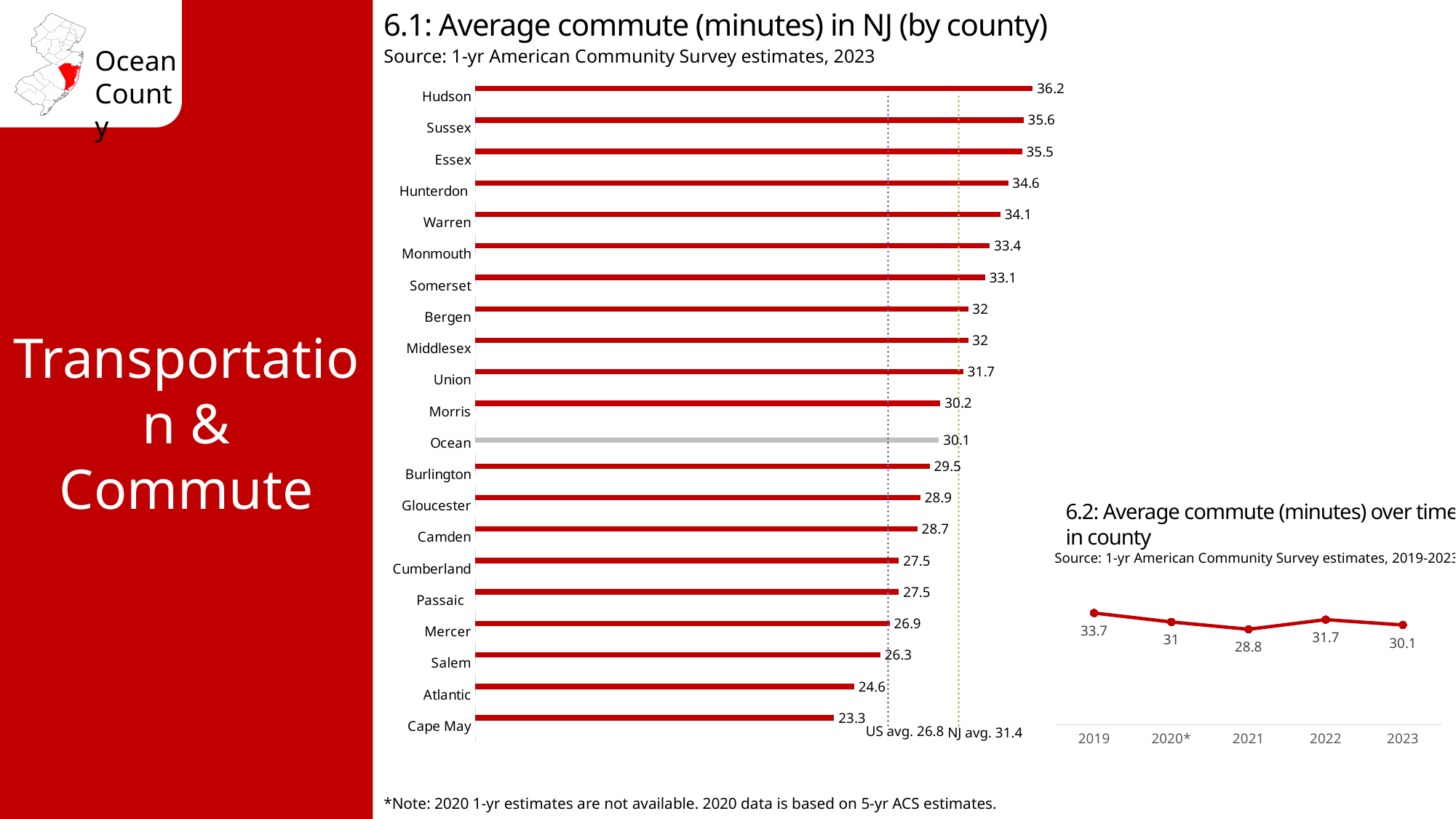
In chart 6.1 (Average commute in NJ by county), what is the average commute for Atlantic County? 24.6 In chart 6.1 (Average commute in NJ by county), which has a longer average commute, Monmouth or Burlington? Monmouth In chart 6.1 (Average commute in NJ by county), which county has the lowest average commute? Cape May In chart 6.1 (Average commute in NJ by county), what NJ average value is marked by the dotted reference line? 31.4 In chart 6.2 (Average commute over time in county), what is the difference between the 2019 and 2023 values? 3.6 In chart 6.1 (Average commute in NJ by county), how many counties are shown? 21 In chart 6.2 (Average commute over time in county), what was the average commute in 2019? 33.7 In chart 6.1 (Average commute in NJ by county), which county has the highest average commute? Hudson What type of chart is chart 6.1 (Average commute in NJ by county)? Bar chart In chart 6.1 (Average commute in NJ by county), what is the difference between Hudson's and Cape May's average commute? 12.9 In chart 6.2 (Average commute over time in county), which year had the lowest average commute? 2021 In chart 6.1 (Average commute in NJ by county), what is the average commute for Ocean County? 30.1